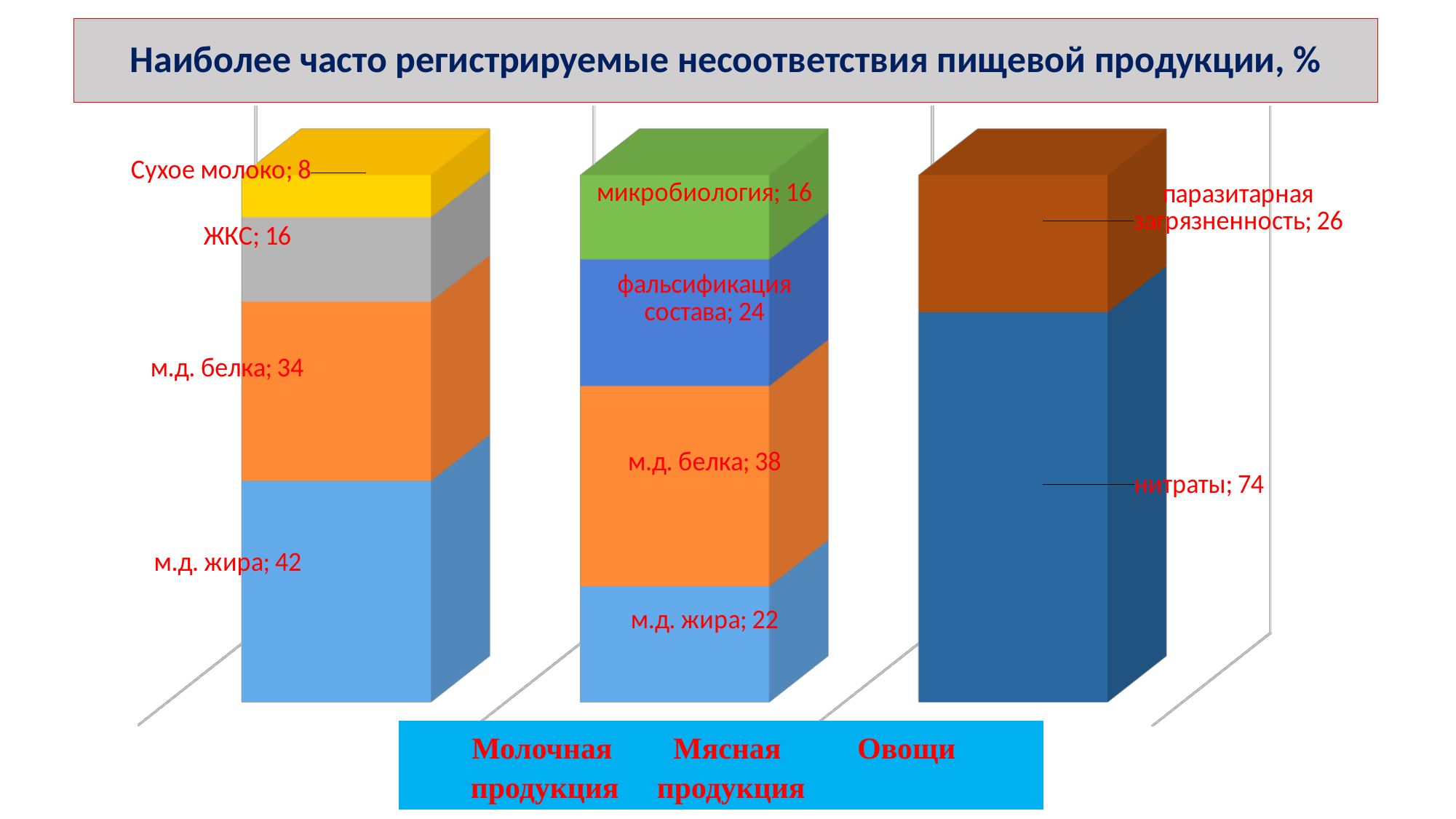
What is the value for фальсификация состава in the Мясная продукция bar? 24 What is the title of the chart? Наиболее часто регистрируемые несоответствия пищевой продукции, % Which segment is the smallest in the Молочная продукция bar? Сухое молоко What type of chart is shown on the slide? Stacked bar chart What is the difference between нитраты and паразитарная загрязненность in the Овощи bar? 48 What is the value for нитраты in the Овощи bar? 74 How many product categories (bars) are shown in the chart? 3 Which segment is the largest in the Мясная продукция bar? м.д. белка What is the value for м.д. жира in the Молочная продукция bar? 42 What is the total of the Мясная продукция stacked bar? 100 Which is larger: м.д. жира in Молочная продукция or м.д. жира in Мясная продукция? Молочная продукция What is the value for Сухое молоко in the Молочная продукция bar? 8